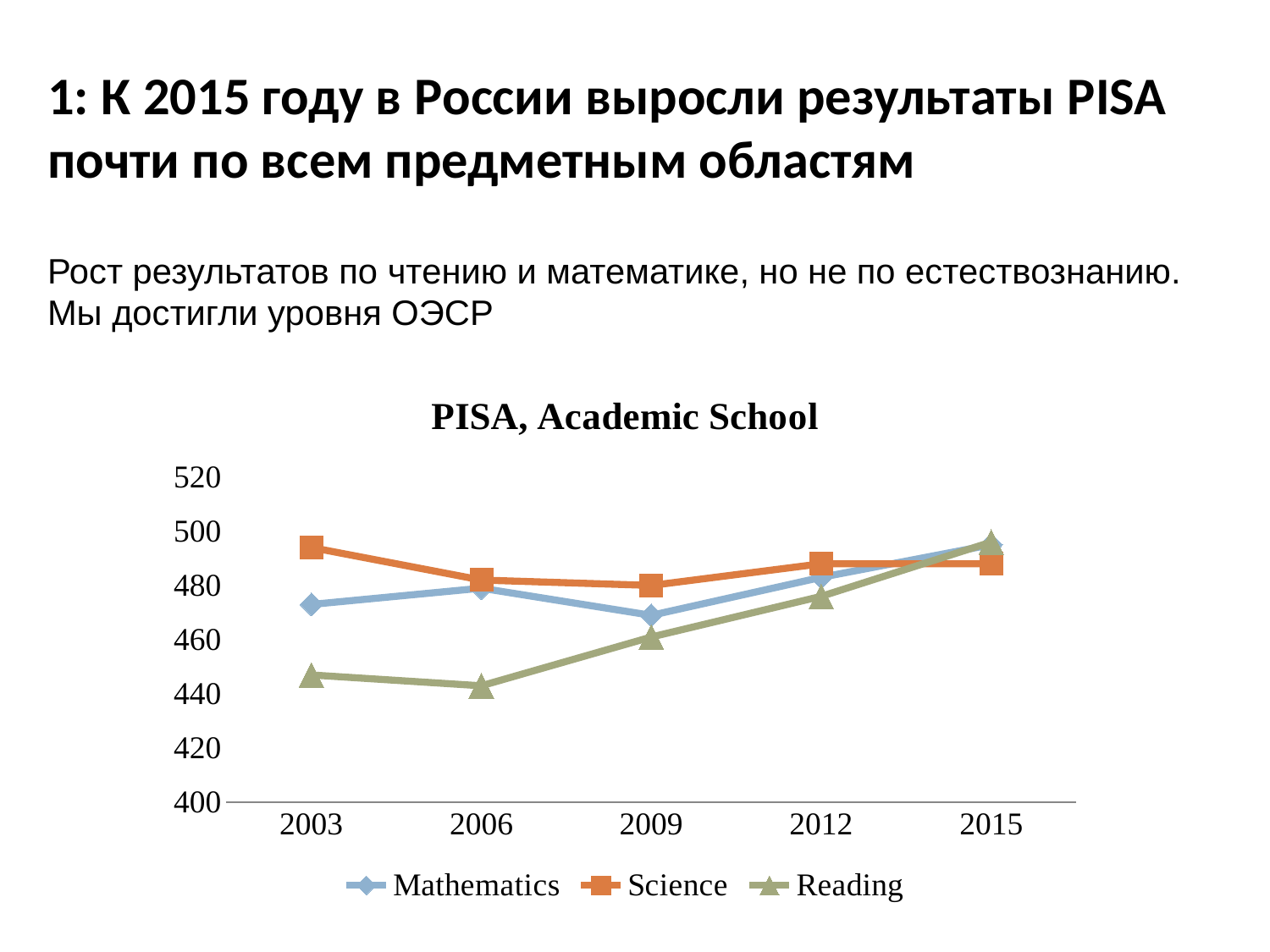
In which year does Reading reach its highest value? 2015 Which series has the lowest value in 2006? Reading Does the Reading series rise or fall from 2006 to 2015? rises Is the value for Science in 2003 greater or less than 480? greater Is the value for Reading in 2003 greater or less than 460? less Is the value for Reading in 2012 greater or less than 460? greater What kind of chart is shown on the slide? line chart In 2009, which is larger: the value for Mathematics or the value for Science? Science How many series does the legend of the chart list? 3 In 2003, which is larger: the value for Science or the value for Reading? Science How many years are plotted along the x axis of the chart? 5